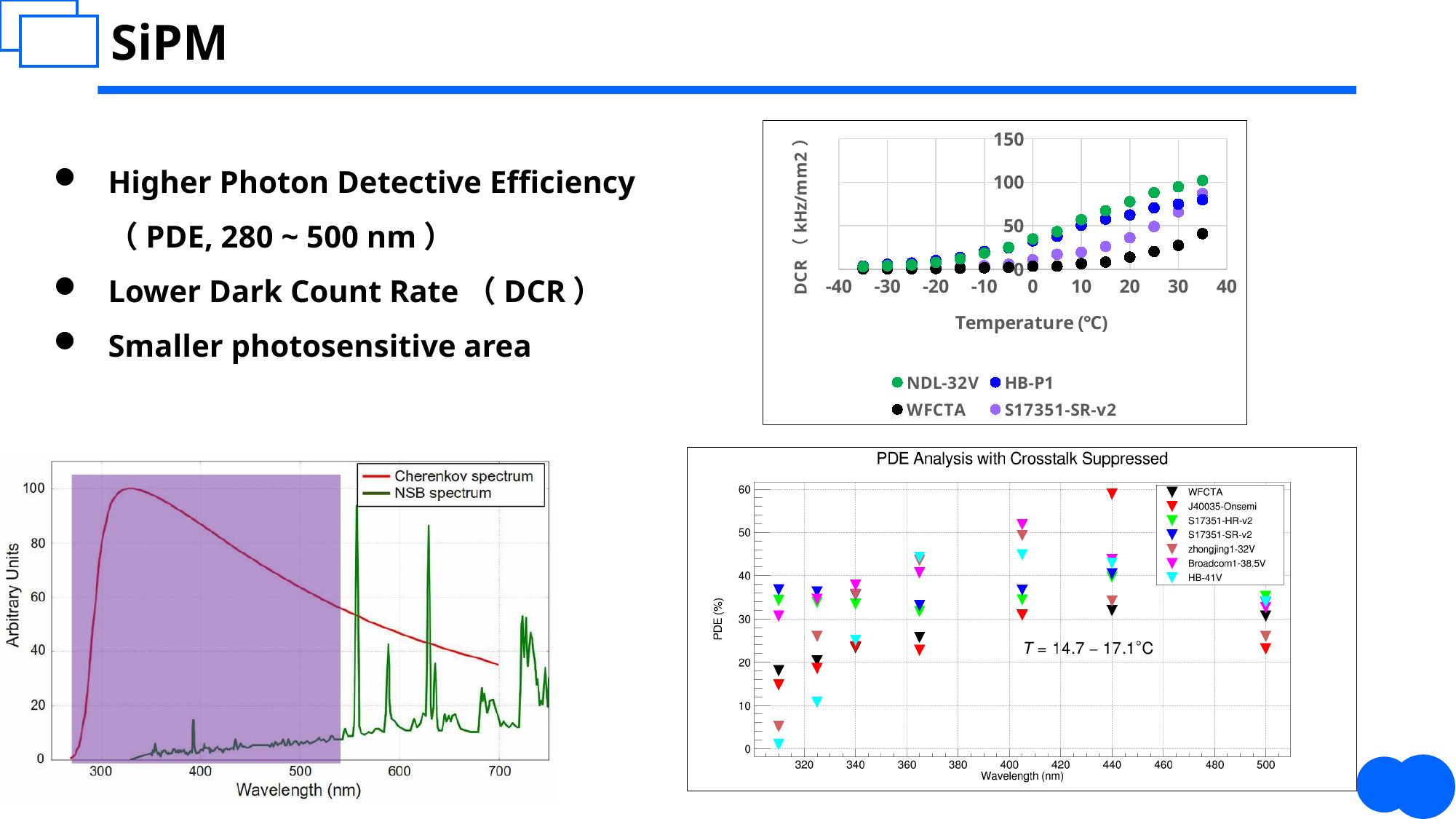
In the top-right DCR chart, is the WFCTA value at 30 °C greater or less than 50? less In the chart titled 'PDE Analysis with Crosstalk Suppressed', is the J40035-Onsemi value at 440 nm greater or less than 50? greater In the chart titled 'PDE Analysis with Crosstalk Suppressed', how many series does the legend list? 7 In the top-right DCR chart, is the NDL-32V value at 35 °C greater or less than 50? greater What kind of chart is the bottom-left spectrum chart? line chart In the top-right DCR chart, does DCR rise or fall as temperature increases? rise In the top-right DCR chart, what is the unit shown on the y-axis label? kHz/mm2 In the top-right DCR chart, which series has the lowest DCR at 35 °C? WFCTA In the top-right DCR chart, which series has the highest DCR at 35 °C? NDL-32V In the bottom-left spectrum chart, how many series does the legend list? 2 In the bottom-left spectrum chart, does the Cherenkov spectrum rise or fall between 400 nm and 700 nm? fall In the top-right DCR chart, how many series does the legend list? 4